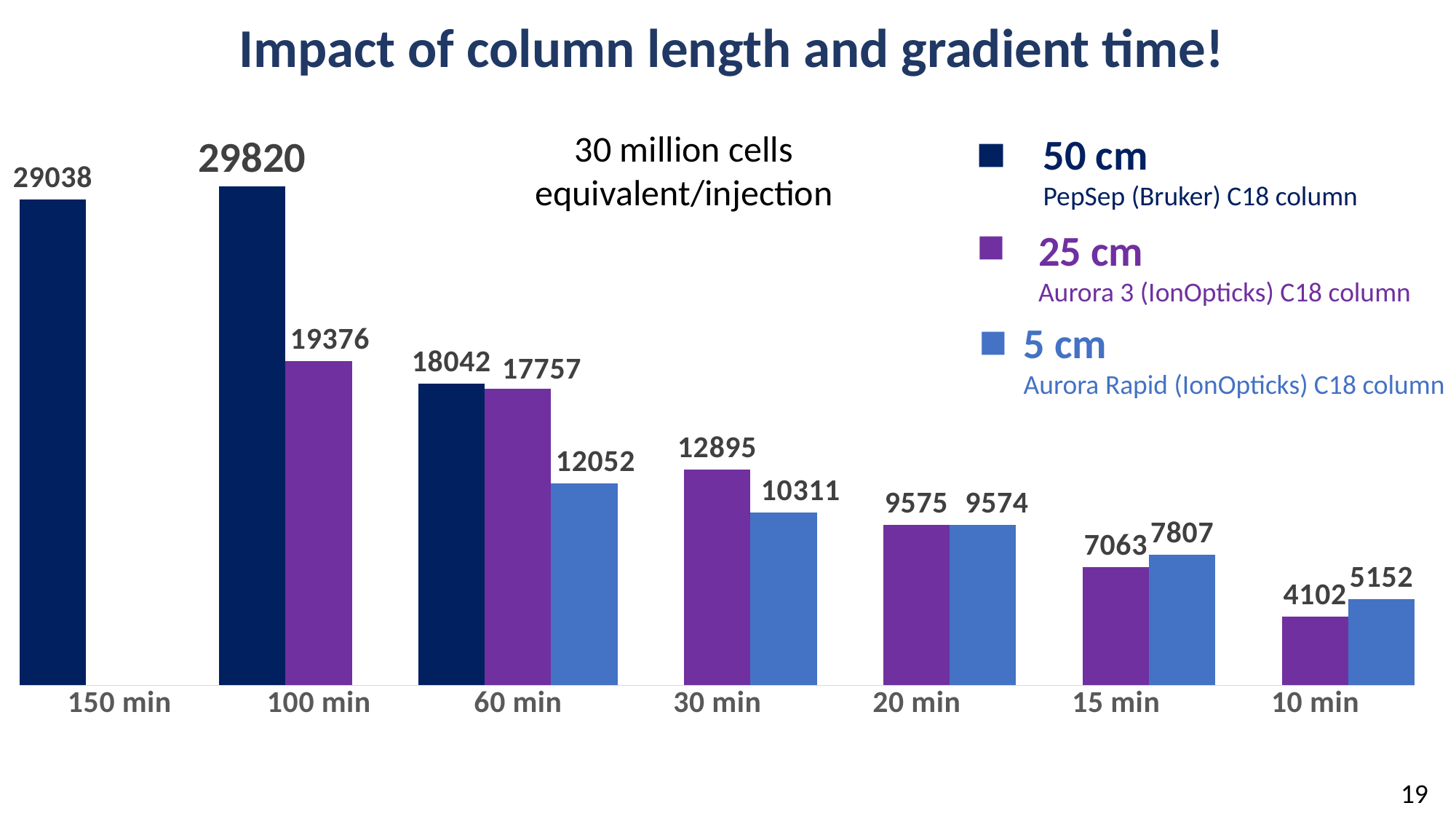
At 15 min, which column has the larger value, 25 cm or 5 cm? 5 cm How many gradient time categories are shown on the x axis? 7 What is the value for the 25 cm column at 30 min? 12895 Which gradient time has the lowest value for the 25 cm column? 10 min What is the difference between the 50 cm and 25 cm values at 100 min? 10444 What kind of chart is shown on the slide? Bar chart How many series does the legend list? 3 What is the value for the 50 cm column at 100 min? 29820 What is the value for the 5 cm column at 10 min? 5152 Do the values for the 5 cm column rise or fall from 60 min to 10 min? Fall Which gradient time has the highest value for the 50 cm column? 100 min Which column is described in the legend as the Aurora Rapid (IonOpticks) C18 column? 5 cm